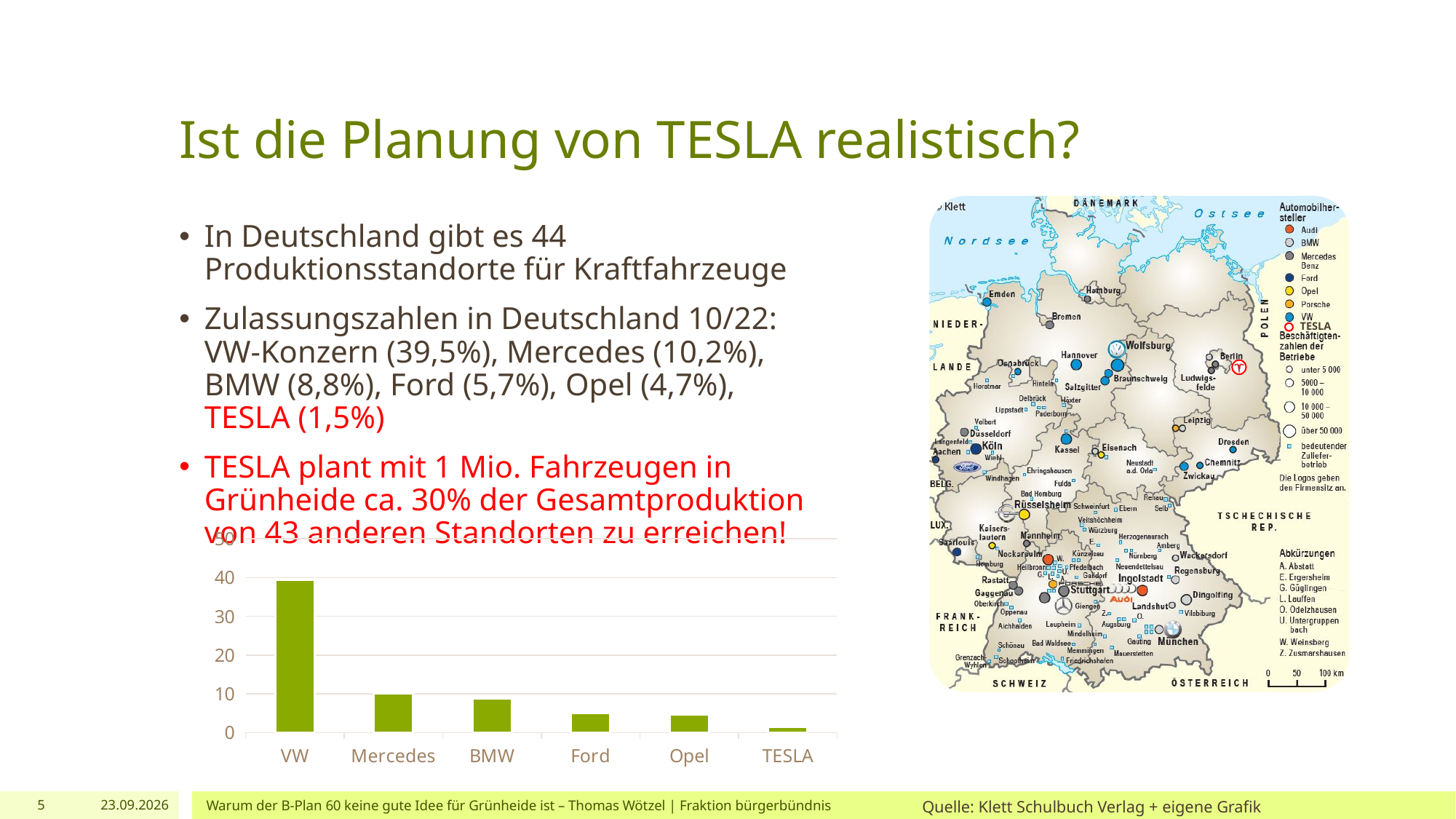
Is the value for BMW greater or less than 10? less Which is larger, the bar for VW or the bar for Mercedes? VW What kind of chart is shown on the slide? bar chart How many categories are shown on the x axis of the bar chart? 6 Is the value for TESLA greater or less than 10? less Which category has the highest bar in the chart? VW Which category has the lowest bar in the chart? TESLA What is the highest tick value shown on the vertical axis of the chart? 50 Which is larger, the bar for Mercedes or the bar for BMW? Mercedes Is the value for VW greater or less than 30? greater Do the bar values rise or fall from left to right along the x axis? fall